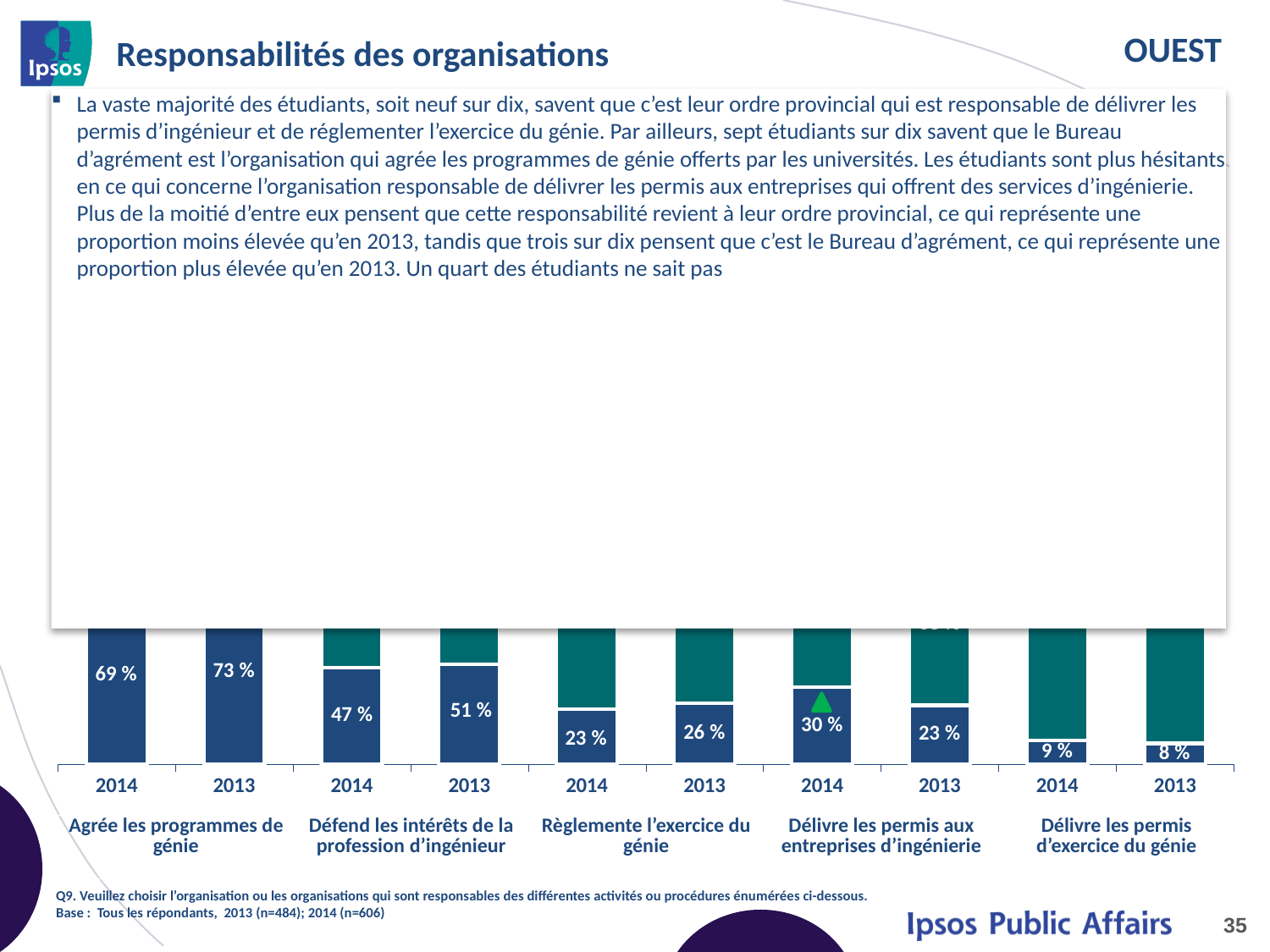
How many bars are plotted in the chart? 10 Among the dark blue segment labels shown, which bar has the lowest value? 2013, Délivre les permis d'exercice du génie (8 %) What is the value of the dark blue segment for 2013 under "Délivre les permis d'exercice du génie"? 8 % Under "Règlemente l'exercice du génie", is the dark blue segment larger for 2014 or 2013? 2013 What kind of chart is shown on the slide? Stacked bar chart What is the difference between the dark blue segment values for 2013 and 2014 under "Agrée les programmes de génie"? 4 % What is the value of the dark blue segment for 2014 under "Délivre les permis aux entreprises d'ingénierie"? 30 % What is the value of the dark blue segment for 2013 under "Défend les intérêts de la profession d'ingénieur"? 51 % How many category groups are labelled along the bottom of the chart? 5 What is the difference between the dark blue segment values for 2014 and 2013 under "Délivre les permis aux entreprises d'ingénierie"? 7 % Among the dark blue segment labels shown, which bar has the highest value? 2013, Agrée les programmes de génie (73 %) What is the value of the dark blue segment for 2014 under "Agrée les programmes de génie"? 69 %